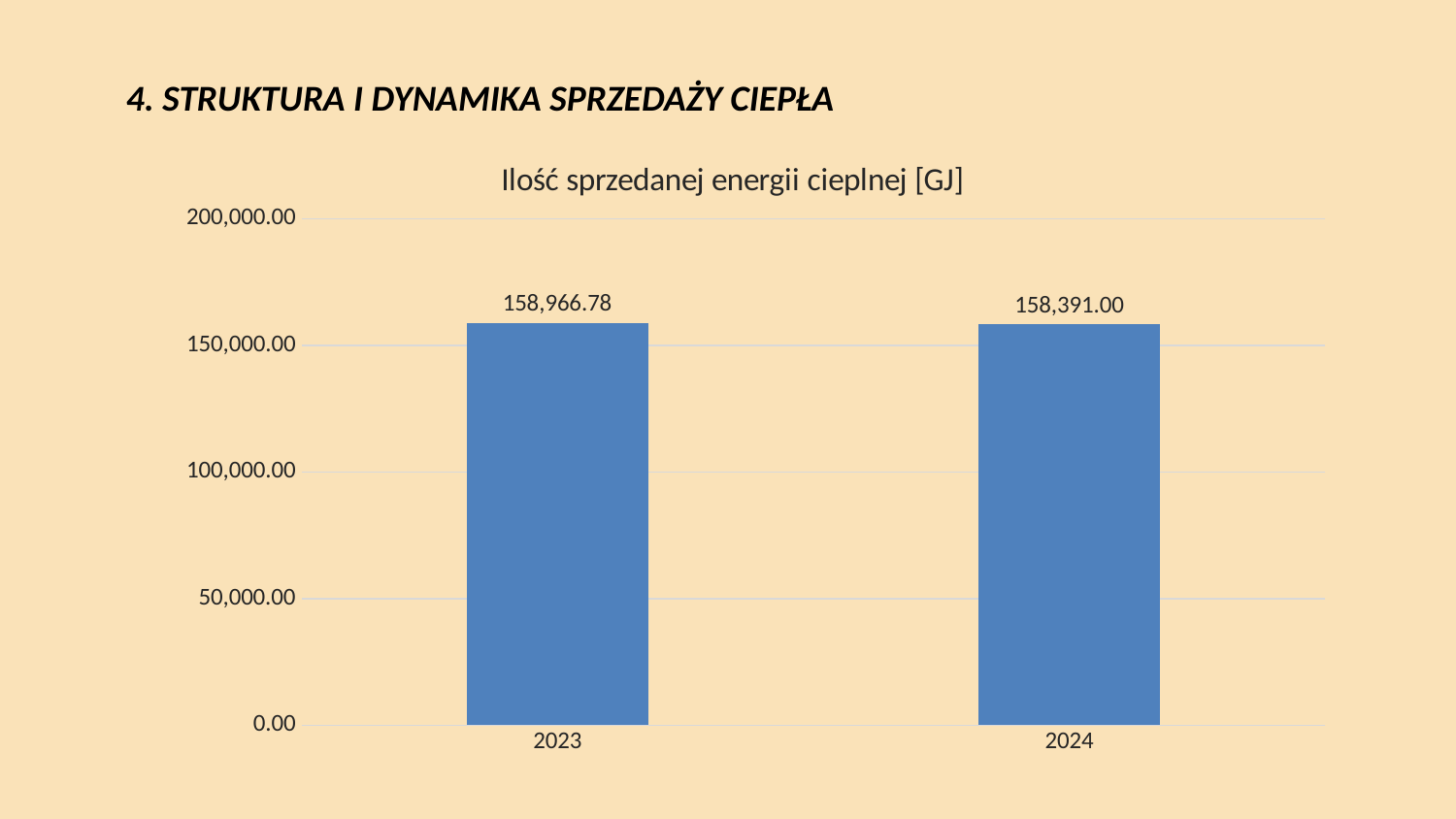
What is the value for 2023? 158,966.78 Is the value for 2023 greater or less than 200,000.00? less Do the values rise or fall from 2023 to 2024? fall How many years are shown on the chart? 2 Which year has the lower value? 2024 What is the difference between the values for 2023 and 2024? 575.78 What is the value for 2024? 158,391.00 Is the value for 2024 greater or less than 150,000.00? greater Is the value for 2024 larger or smaller than the value for 2023? smaller What is the title of the chart? Ilość sprzedanej energii cieplnej [GJ] Which year has the higher value? 2023 What kind of chart is shown on the slide? bar chart